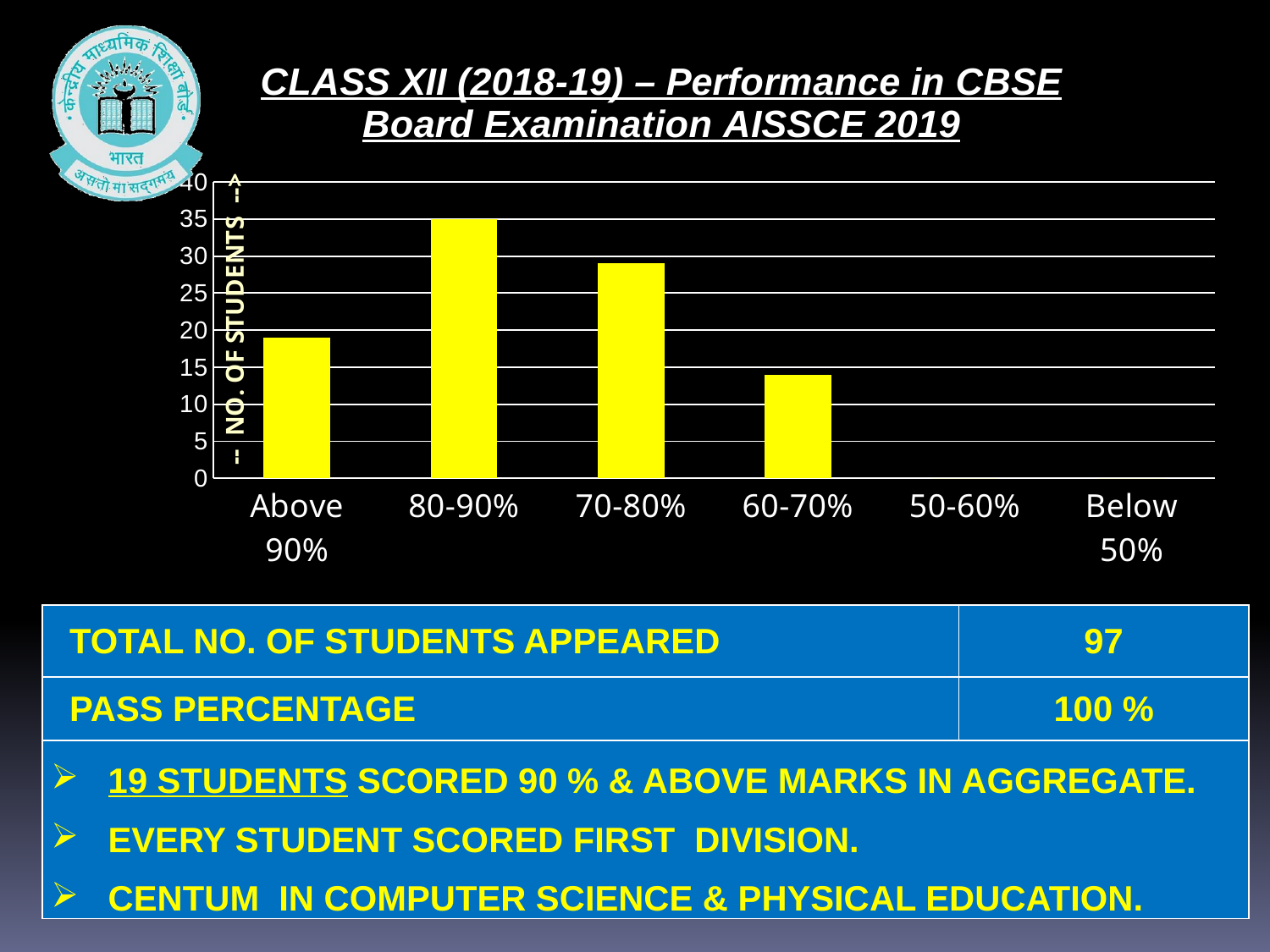
How many students scored in the 80-90% range? 35 What is the label on the y axis of the chart? NO. OF STUDENTS How many score-range categories are shown on the x axis of the chart? 6 Which has more students: 70-80% or 80-90%? 80-90% Is the number of students in the 70-80% range greater or less than 25? greater Which score range has the highest number of students? 80-90% How many students scored Above 90%? 19 What kind of chart is shown on the slide? bar chart How many score-range categories have no bar (zero students)? 2 Which has more students: Above 90% or 60-70%? Above 90% What is the difference between the number of students in the 80-90% range and the number Above 90%? 16